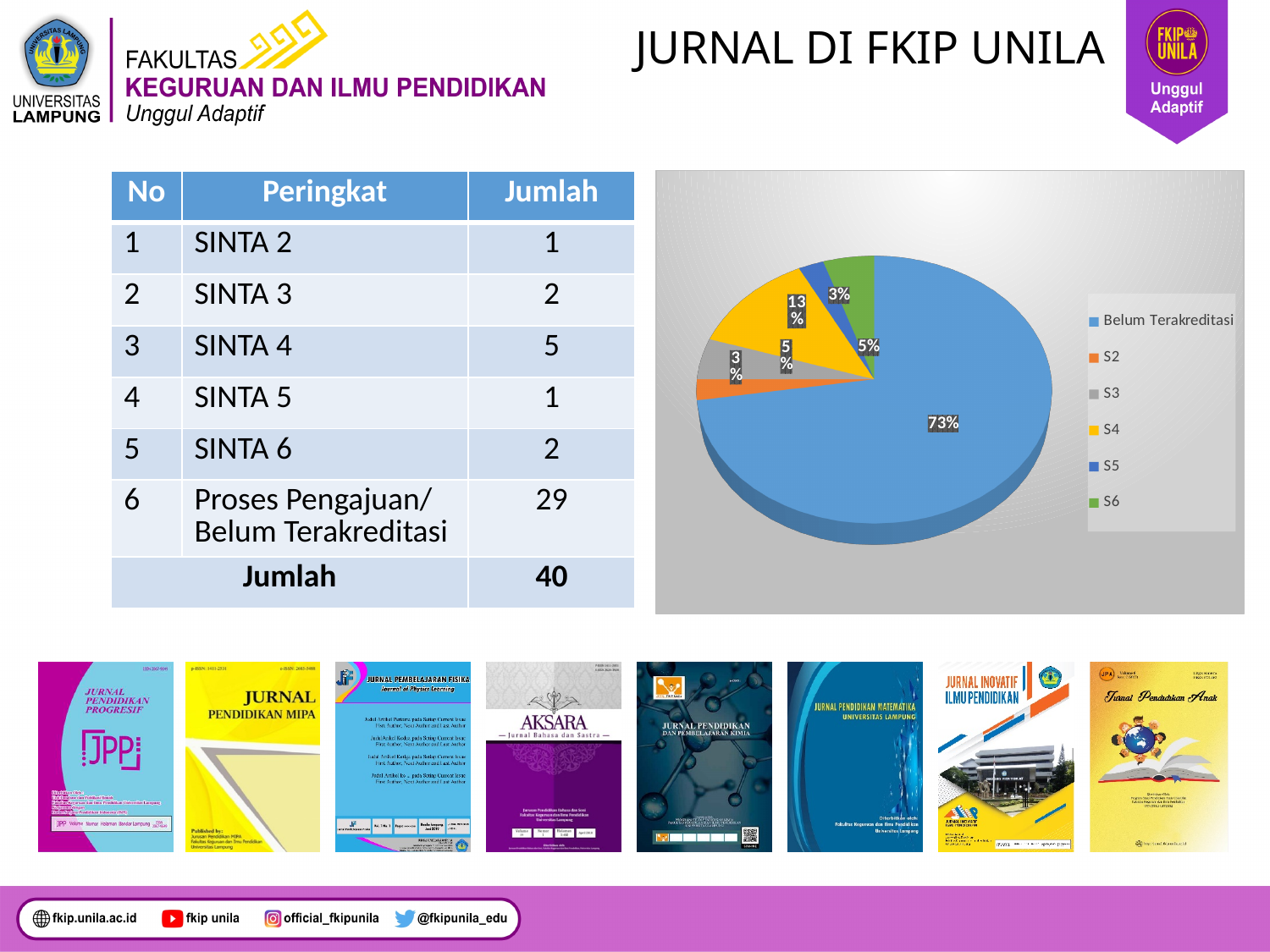
Which slice is larger in the pie chart, Belum Terakreditasi or S4? Belum Terakreditasi What percentage of the pie does S3 account for? 5% What kind of chart is shown on the slide? pie chart By how many percentage points does the Belum Terakreditasi slice exceed the S4 slice? 60 How many entries does the pie chart's legend list? 6 How many slices does the pie chart have? 6 What percentage of the pie does S4 account for? 13% Which category has the largest slice in the pie chart? Belum Terakreditasi What percentage of the pie does Belum Terakreditasi account for? 73% Which slice is larger in the pie chart, S4 or S3? S4 Which legend entry is shown in yellow in the pie chart? S4